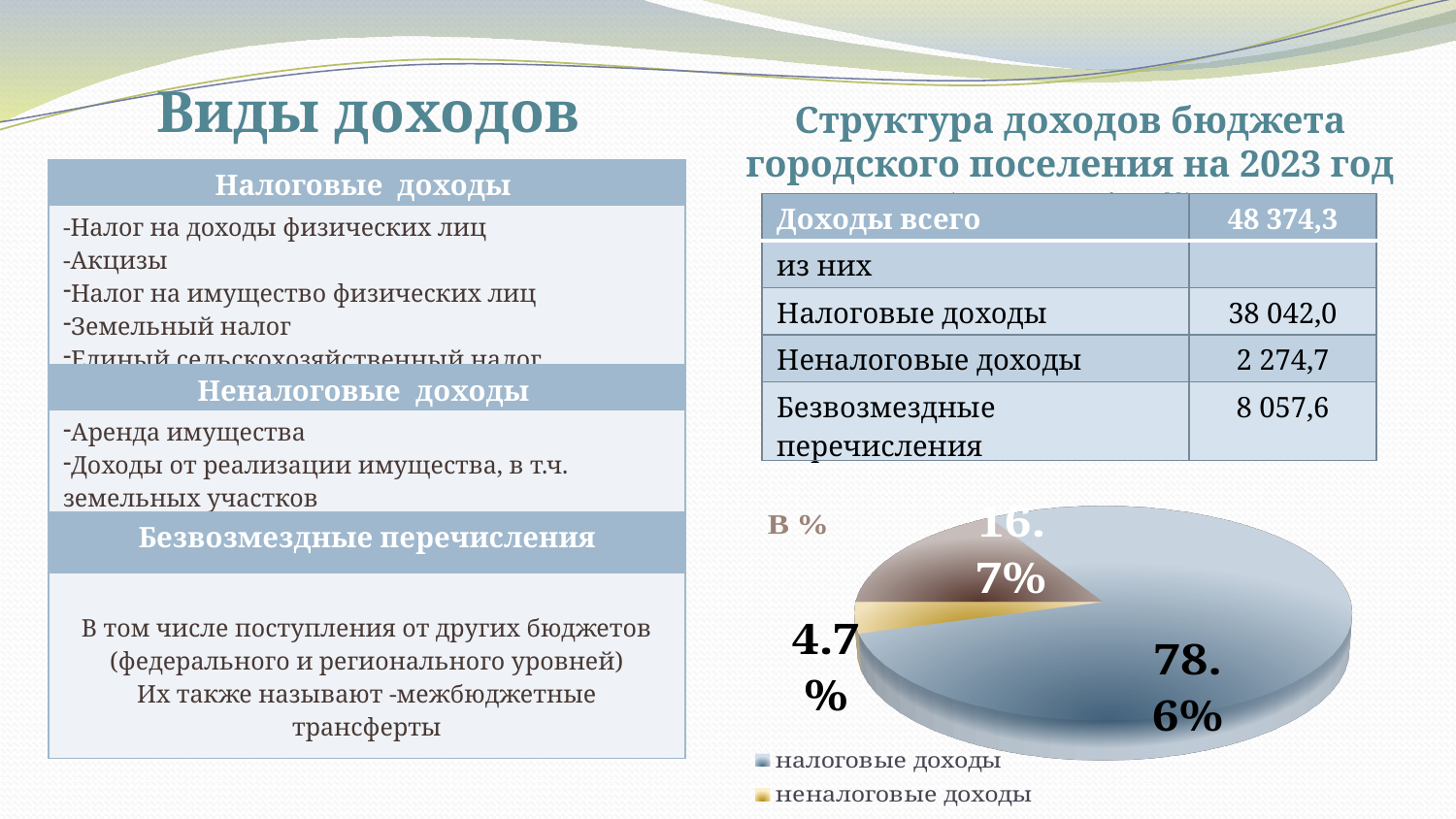
By how many percentage points does the share of налоговые доходы exceed the share of неналоговые доходы? 73.9 How many slices does the pie chart have? 3 What colour is the slice for налоговые доходы in the pie chart? blue What share of the pie chart does неналоговые доходы have? 4.7% Which category has the smallest slice in the pie chart? неналоговые доходы Is the share of налоговые доходы greater or less than 50%? greater Which is larger in the pie chart, налоговые доходы or неналоговые доходы? налоговые доходы What kind of chart is shown on the slide? pie chart What is the value shown on the largest slice of the pie chart? 78.6% What share of the pie chart does налоговые доходы have? 78.6% What is the title of the pie chart? В % Which category has the largest slice in the pie chart? налоговые доходы